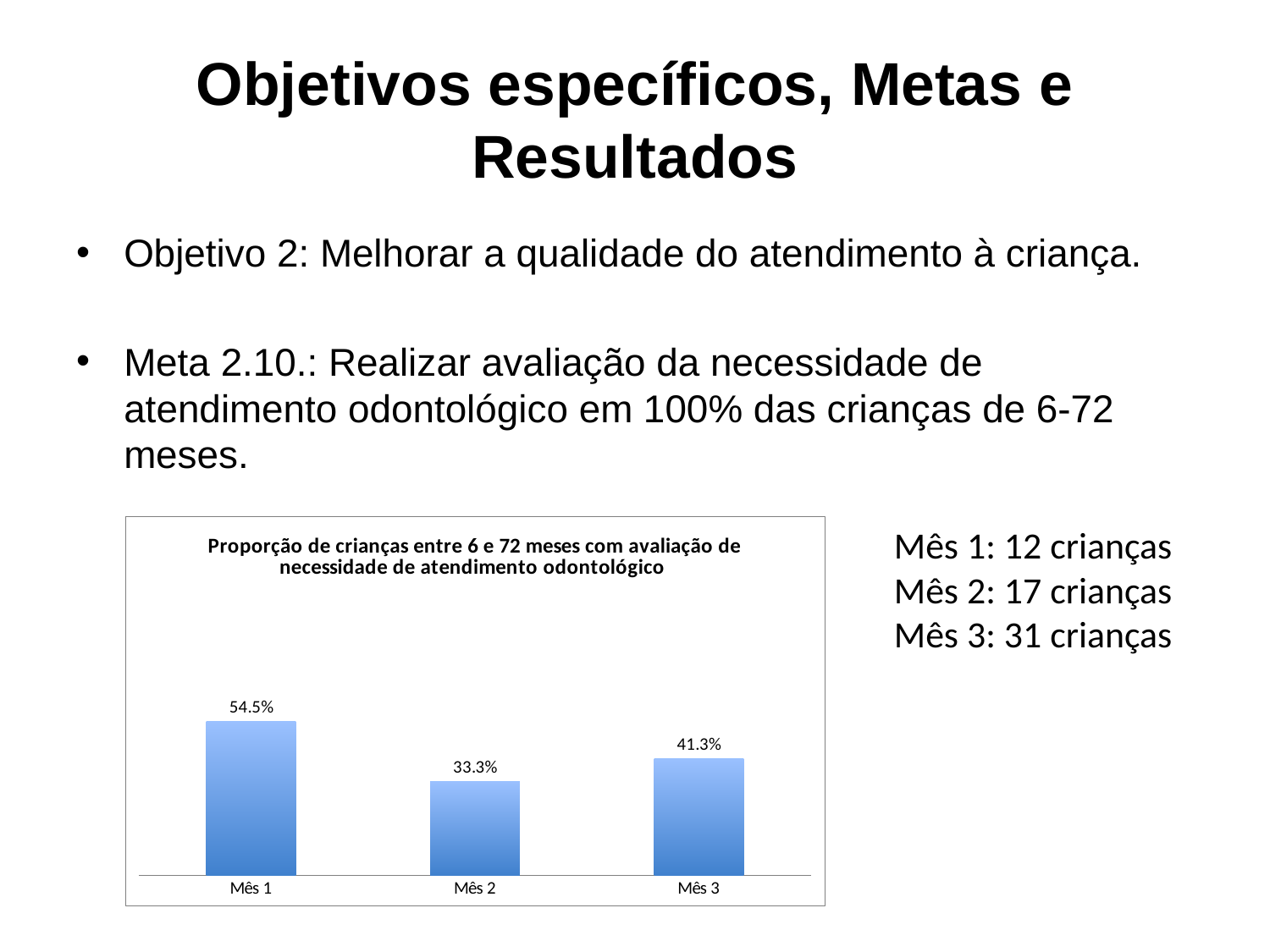
Does the value rise or fall from Mês 1 to Mês 2? Fall What is the value for Mês 1? 54.5% How many months are shown on the chart? 3 What is the difference between the values for Mês 1 and Mês 2? 21.2% What is the difference between the values for Mês 3 and Mês 2? 8.0% What kind of chart is shown on the slide? Bar chart What is the title of the chart? Proporção de crianças entre 6 e 72 meses com avaliação de necessidade de atendimento odontológico What is the value for Mês 3? 41.3% What is the value for Mês 2? 33.3% Which is larger, the value for Mês 2 or the value for Mês 3? Mês 3 Which month has the highest value? Mês 1 Which month has the lowest value? Mês 2